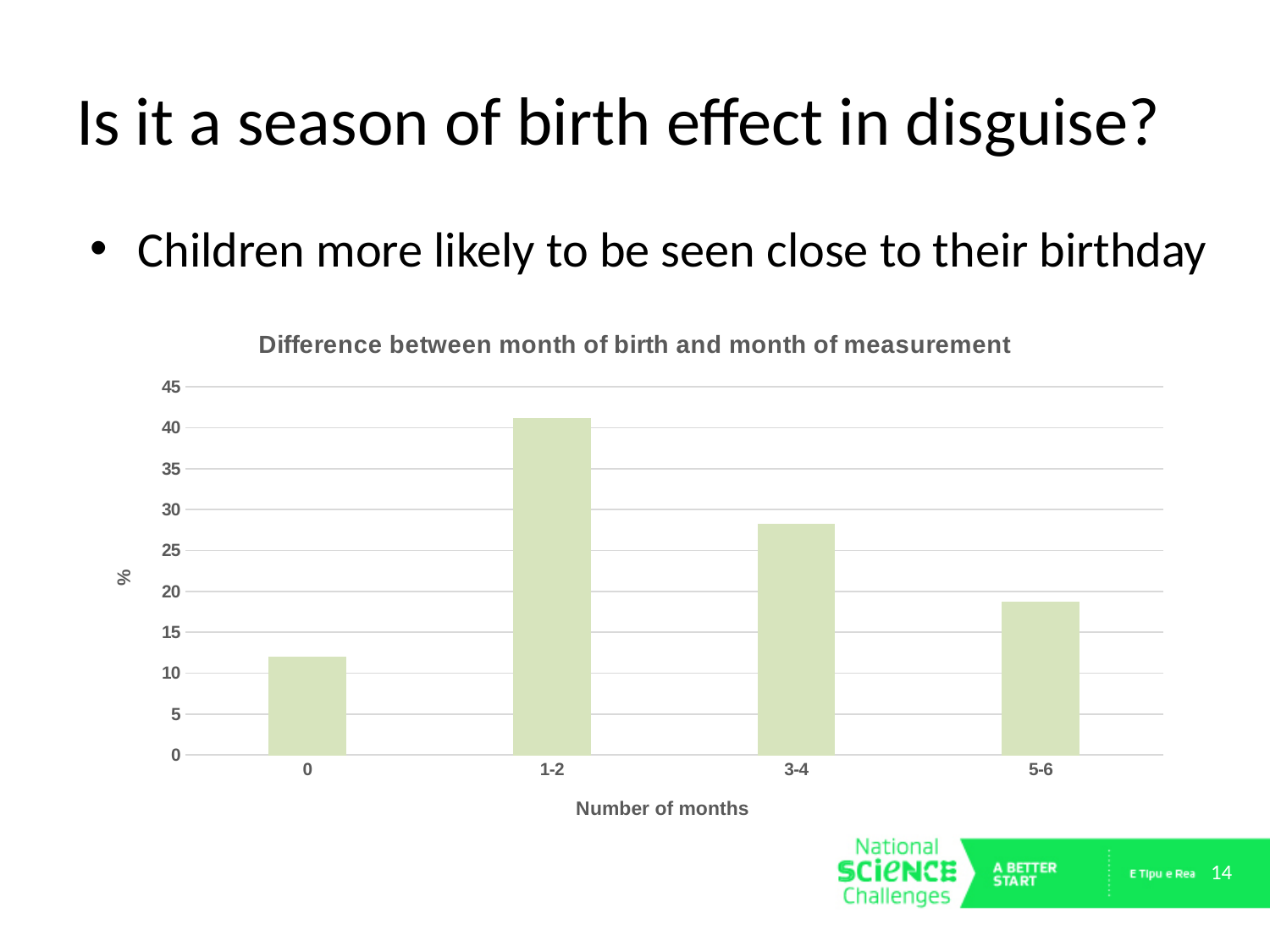
Which has the larger percentage, the 3-4 months category or the 5-6 months category? 3-4 Is the value for the 0 months category greater or less than 15? less What is the title of the chart? Difference between month of birth and month of measurement Which number-of-months category has the lowest percentage? 0 Is the value for the 1-2 months category greater or less than 40? greater Is the value for the 3-4 months category greater or less than 25? greater Which has the larger percentage, the 0 months category or the 1-2 months category? 1-2 What kind of chart is shown on the slide? bar chart What is the label of the x axis of the chart? Number of months How many categories are shown on the x axis of the chart? 4 Which number-of-months category has the highest percentage? 1-2